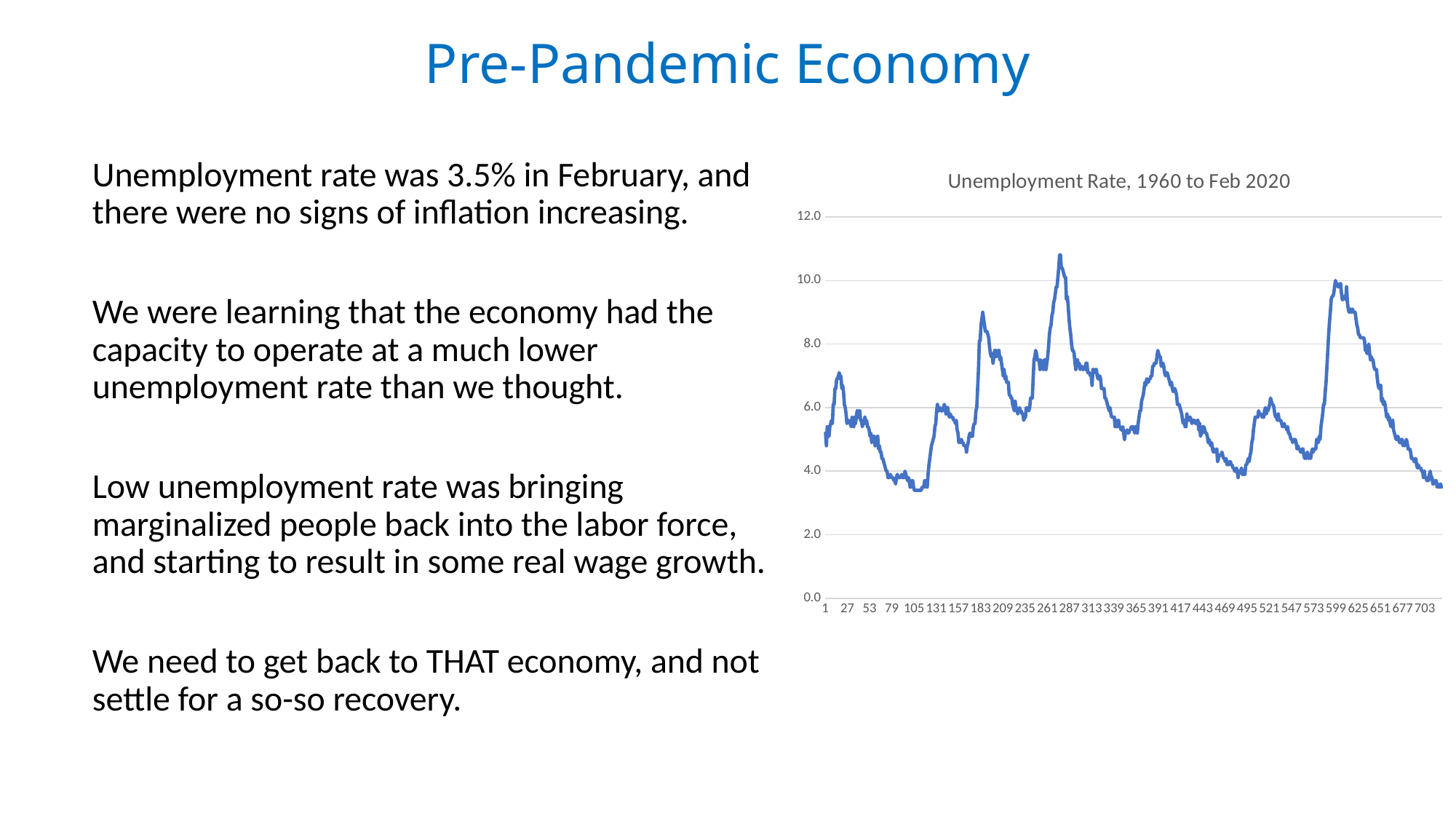
Is the highest value reached by the line greater or less than 10.0? greater Is the value at x = 677 greater or less than 4.0? greater What kind of chart is shown on the slide? line chart How many data series are plotted in the chart? 1 What is the title of the chart? Unemployment Rate, 1960 to Feb 2020 Does the line rise or fall between x = 599 and x = 703? fall Is the value at x = 105 greater or less than 4.0? less Does the line rise or fall between x = 105 and x = 131? rise What is the highest value labelled on the vertical axis? 12.0